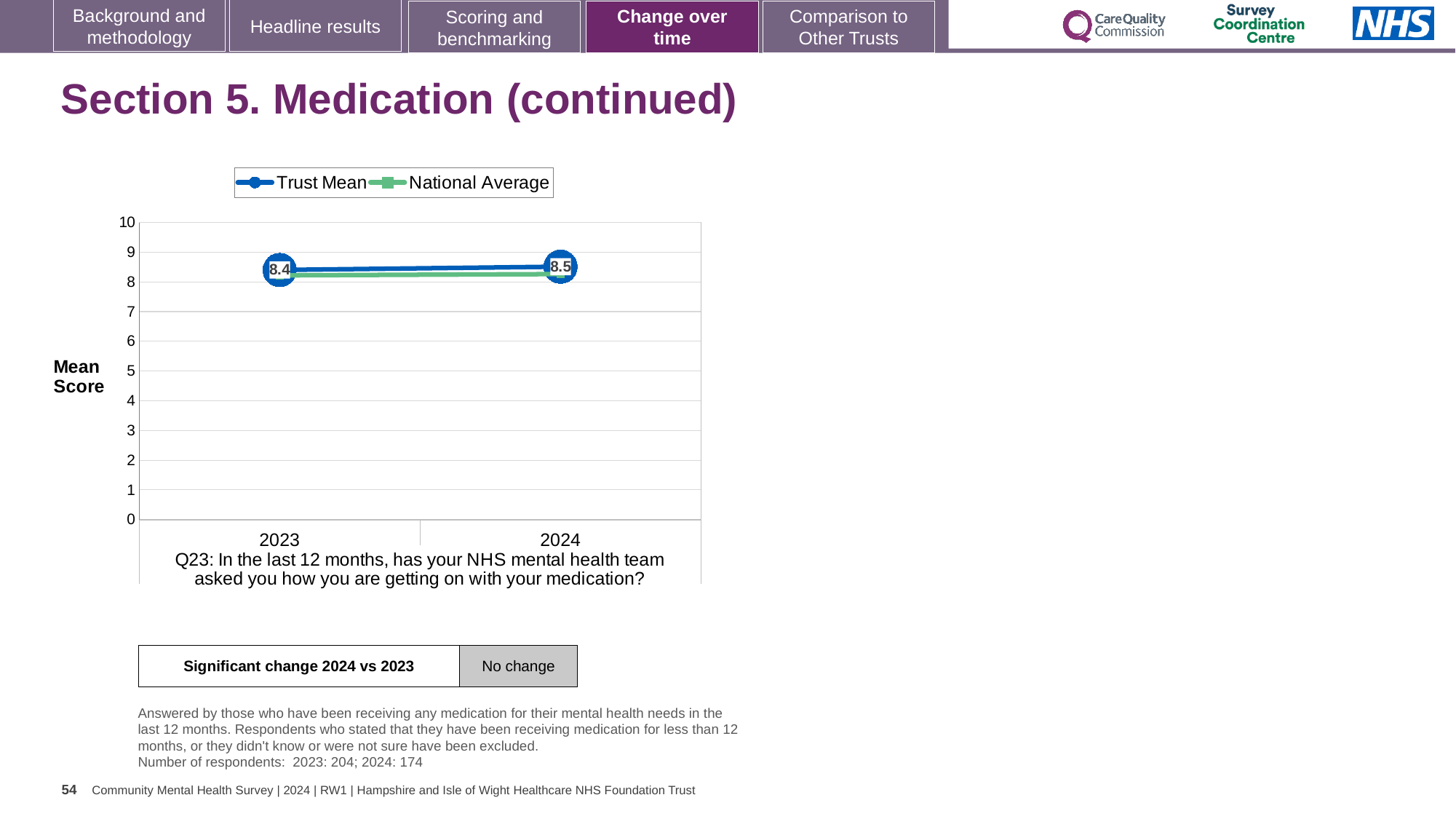
What kind of chart is shown on the slide? line chart Is the National Average value for 2024 greater or less than 7? greater What is the Trust Mean score for 2024? 8.5 Does the Trust Mean rise or fall from 2023 to 2024? rise What is the Trust Mean score for 2023? 8.4 How many years are plotted on the x axis of the chart? 2 What are the two series named in the chart legend? Trust Mean and National Average How many series does the chart legend list? 2 What is the label on the y axis of the chart? Mean Score In which year is the Trust Mean higher, 2023 or 2024? 2024 By how much did the Trust Mean change from 2023 to 2024? 0.1 In 2024, which is higher: the Trust Mean or the National Average? Trust Mean